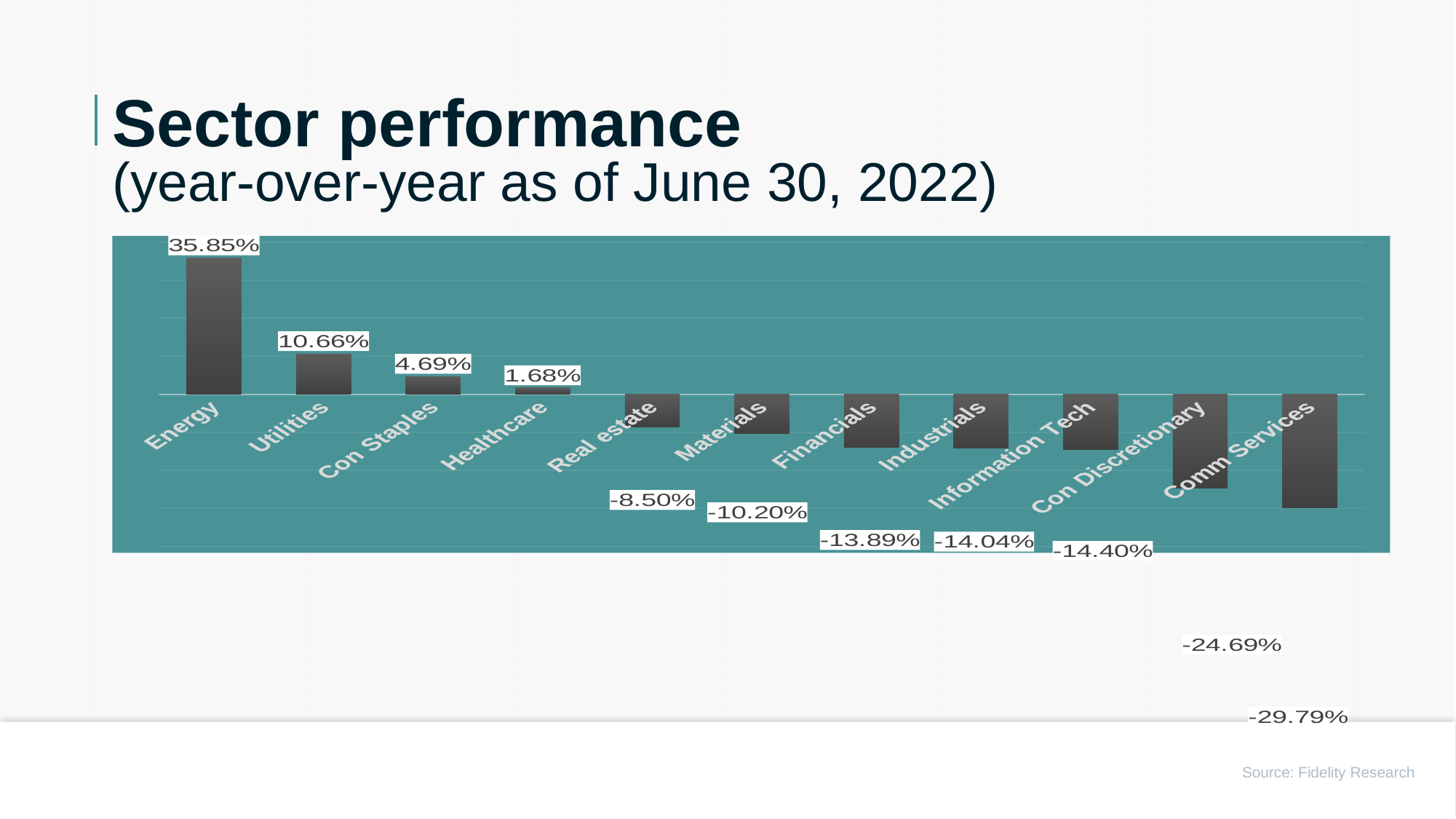
Which sector has the lowest value? Comm Services What is the value for Energy? 35.85% What is the value for Utilities? 10.66% What is the source cited for the chart? Fidelity Research Which is larger, the value for Con Staples or the value for Healthcare? Con Staples What is the difference between the values for Energy and Utilities? 25.19% What is the value for Comm Services? -29.79% How many sectors are shown in the chart? 11 What is the value for Information Tech? -14.40% What kind of chart is shown on the slide? Bar chart Which sector has the highest value? Energy Do the values rise or fall from left to right across the sectors? Fall